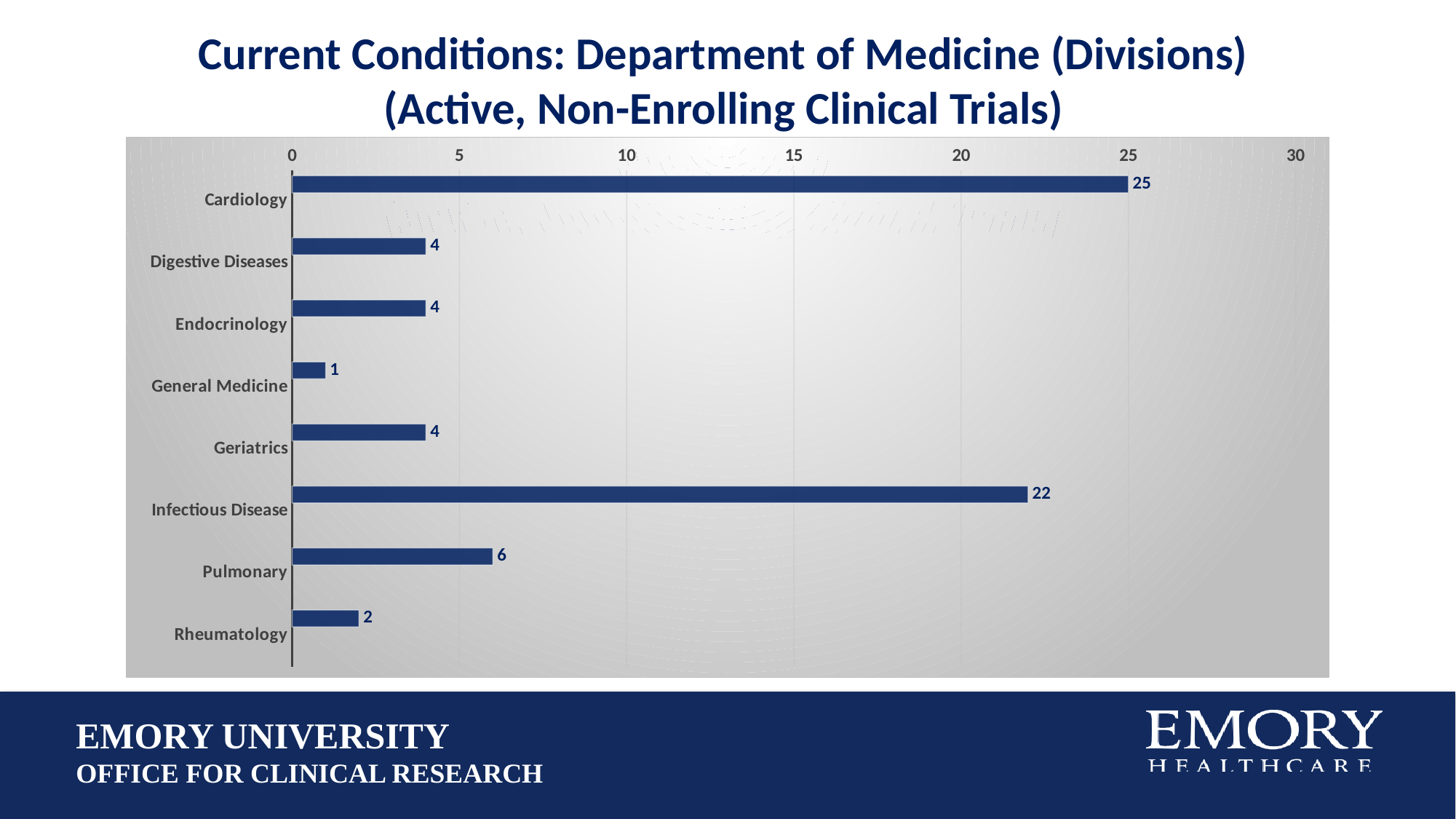
How many divisions are shown in the chart? 8 Which is larger, the value for Pulmonary or the value for Geriatrics? Pulmonary What is the title of the slide? Current Conditions: Department of Medicine (Divisions) (Active, Non-Enrolling Clinical Trials) What is the value for Infectious Disease? 22 What is the value for Cardiology? 25 Is the value for Infectious Disease greater or less than 20? greater Which division has the highest value? Cardiology What is the value for Rheumatology? 2 What kind of chart is shown on the slide? Bar chart What is the difference between the values for Cardiology and Infectious Disease? 3 Which division has the lowest value? General Medicine What is the value for Pulmonary? 6